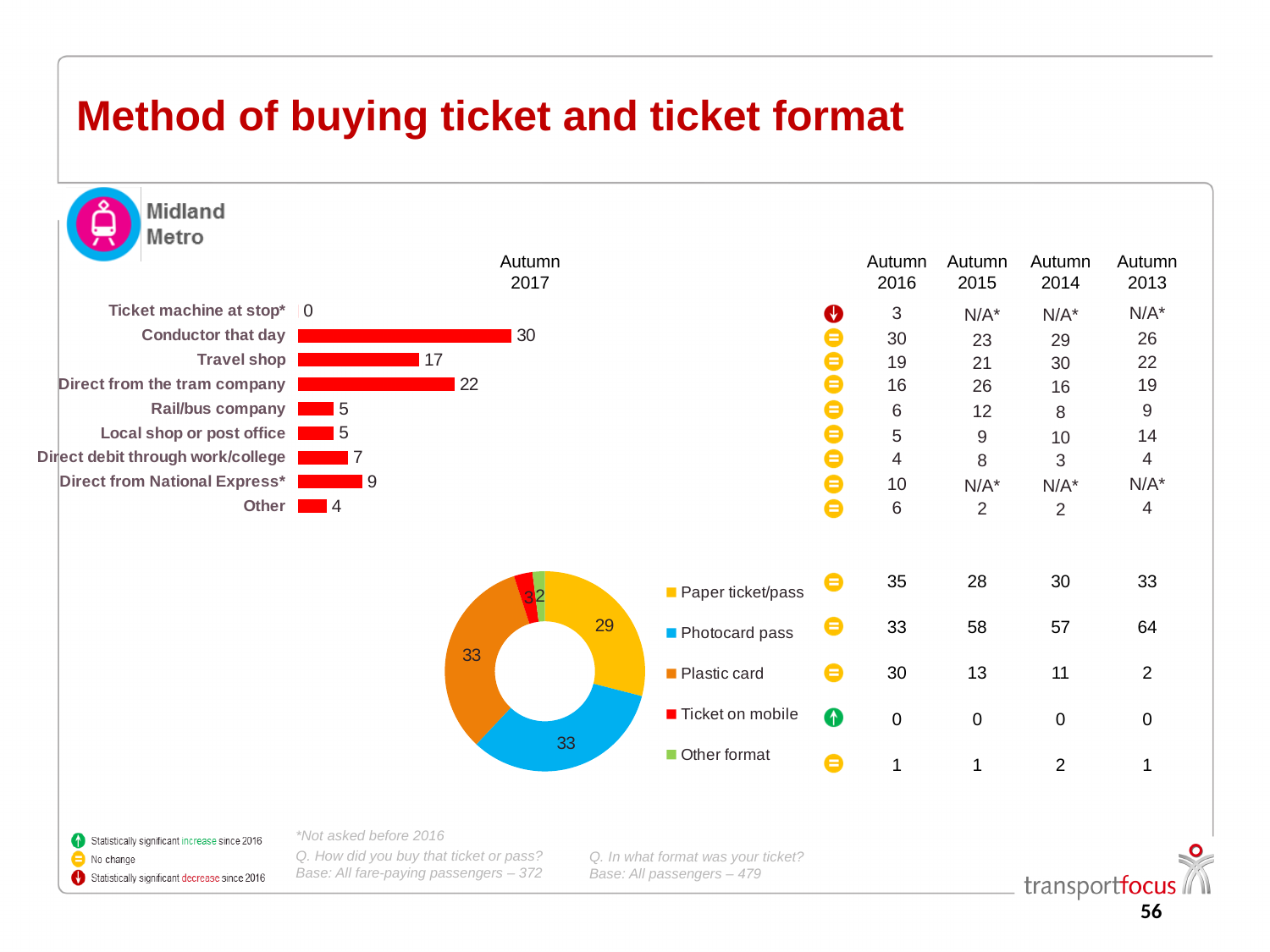
In the doughnut chart, what is the value for Paper ticket/pass? 29 In the bar chart, which method of buying a ticket has the lowest value? Ticket machine at stop* In the doughnut chart, which ticket format has the lowest value? Other format How many entries does the legend of the doughnut chart list? 5 In the bar chart, what is the value for Conductor that day in Autumn 2017? 30 In the bar chart, which method of buying a ticket has the highest value? Conductor that day In the bar chart, which is larger: Direct debit through work/college or Other? Direct debit through work/college In the bar chart, what is the value for Direct from National Express*? 9 How many categories are shown in the bar chart? 9 In the bar chart, what is the difference between Conductor that day and Travel shop? 13 What kind of chart is the chart showing methods of buying a ticket? Bar chart In the bar chart, what is the value for Direct from the tram company? 22